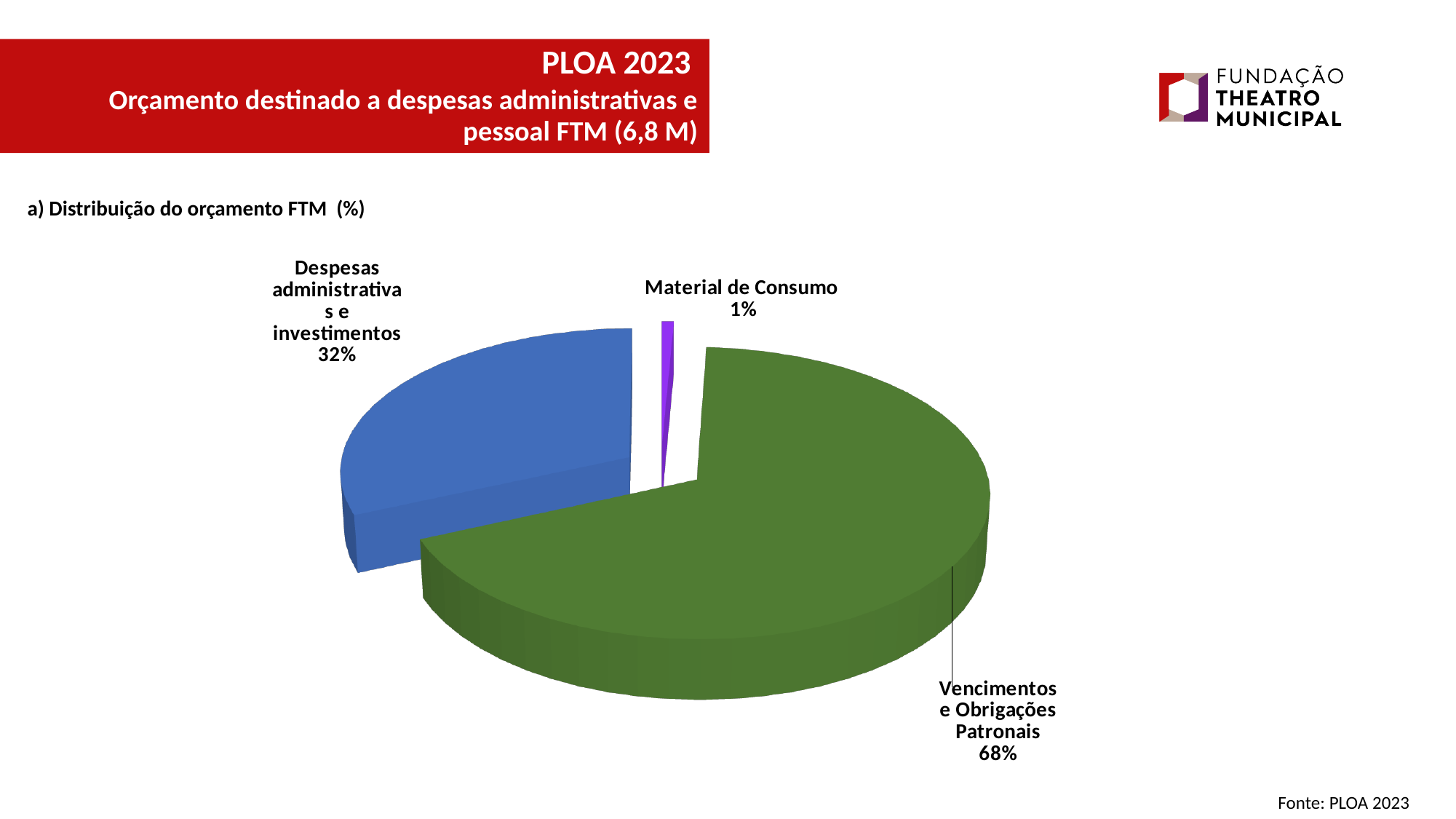
What share of the FTM budget goes to Despesas administrativas e investimentos? 32% What share of the FTM budget goes to Material de Consumo? 1% How many slices does the pie chart have? 3 What colour is the slice for Vencimentos e Obrigações Patronais? Green What is the difference in percentage points between Vencimentos e Obrigações Patronais and Despesas administrativas e investimentos? 36 What share of the FTM budget goes to Vencimentos e Obrigações Patronais? 68% What is the source cited for the chart data? PLOA 2023 What kind of chart is shown on the slide? Pie chart Which category has the smallest share of the pie? Material de Consumo What is the title of the chart? a) Distribuição do orçamento FTM (%) Which category has the largest share of the pie? Vencimentos e Obrigações Patronais Which is larger: the share for Despesas administrativas e investimentos or the share for Material de Consumo? Despesas administrativas e investimentos